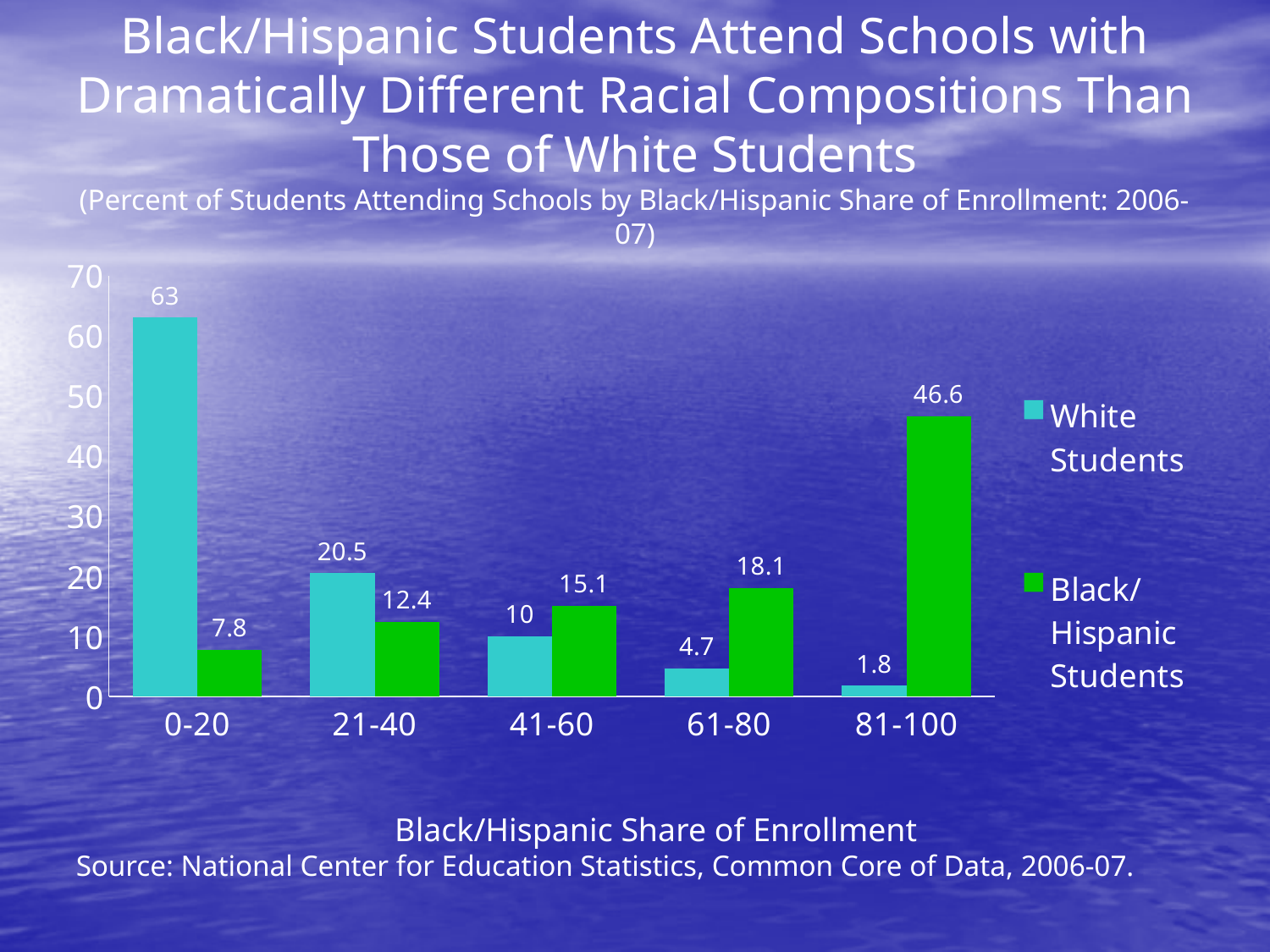
In the 61-80 category, which series has the larger value, White Students or Black/Hispanic Students? Black/Hispanic Students Which category has the highest value for White Students? 0-20 What is the difference between the White Students value and the Black/Hispanic Students value in the 21-40 category? 8.1 What kind of chart is shown on the slide? bar chart How many series does the legend list? 2 What is the value for Black/Hispanic Students in the 81-100 category? 46.6 What is the value for White Students in the 0-20 category? 63 What is the value for Black/Hispanic Students in the 41-60 category? 15.1 How many categories are shown on the x axis? 5 Which category has the lowest value for Black/Hispanic Students? 0-20 Do the values for White Students rise or fall from the 0-20 category to the 81-100 category? fall Is the value for Black/Hispanic Students in the 81-100 category greater or less than 40? greater